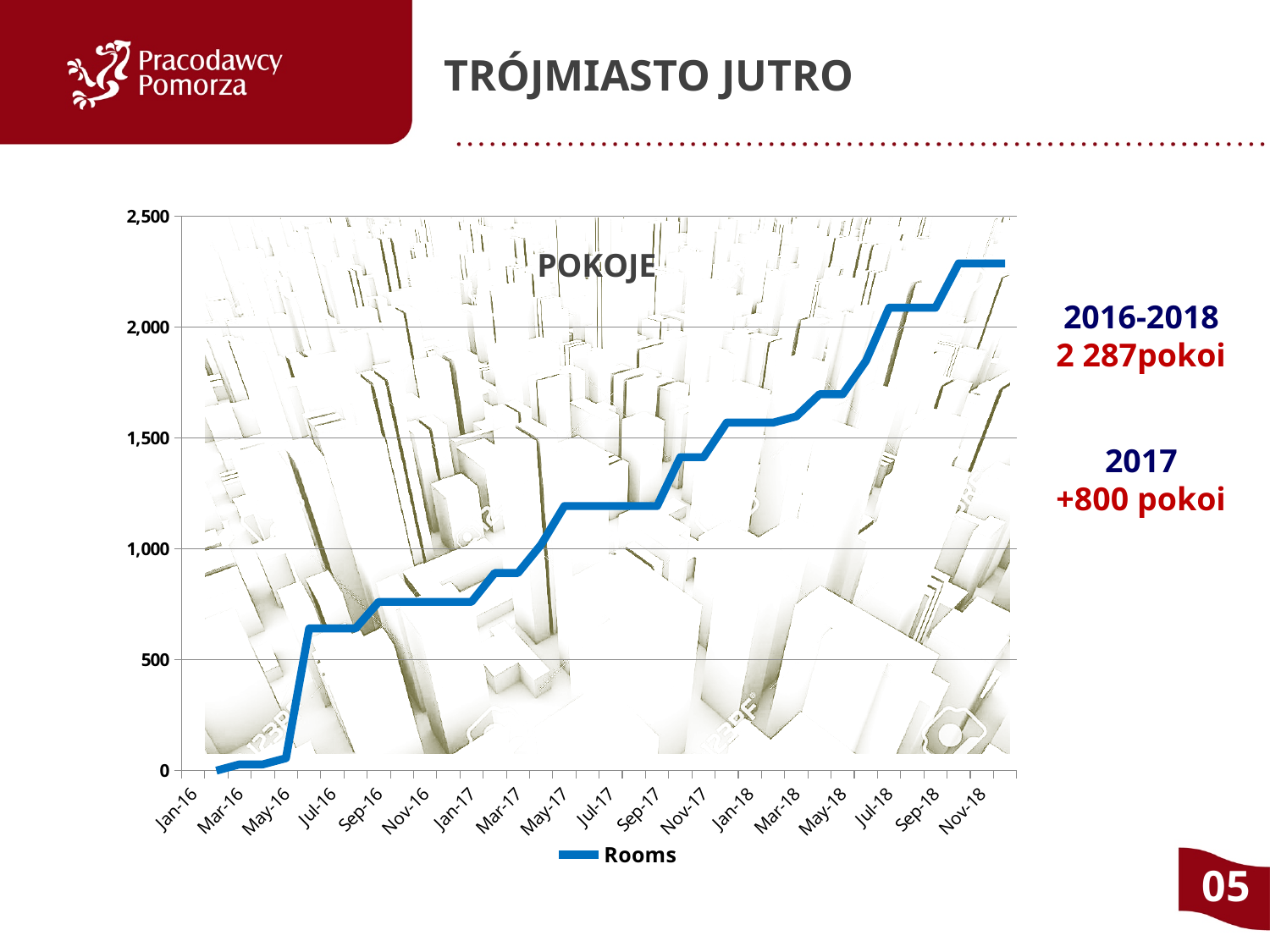
What is the name of the series shown in the chart legend? Rooms Is the value for Rooms at Mar-16 greater or less than 500? less Is the value for Rooms at Jan-17 greater or less than 1,000? less Do the values of the Rooms series rise or fall from Jan-16 to Nov-18? rise Is the value for Rooms at Nov-18 greater or less than 2,000? greater What kind of chart is shown on the slide? line chart How many series does the chart legend list? 1 What is the title printed on the chart? POKOJE How many month labels are printed along the x axis? 18